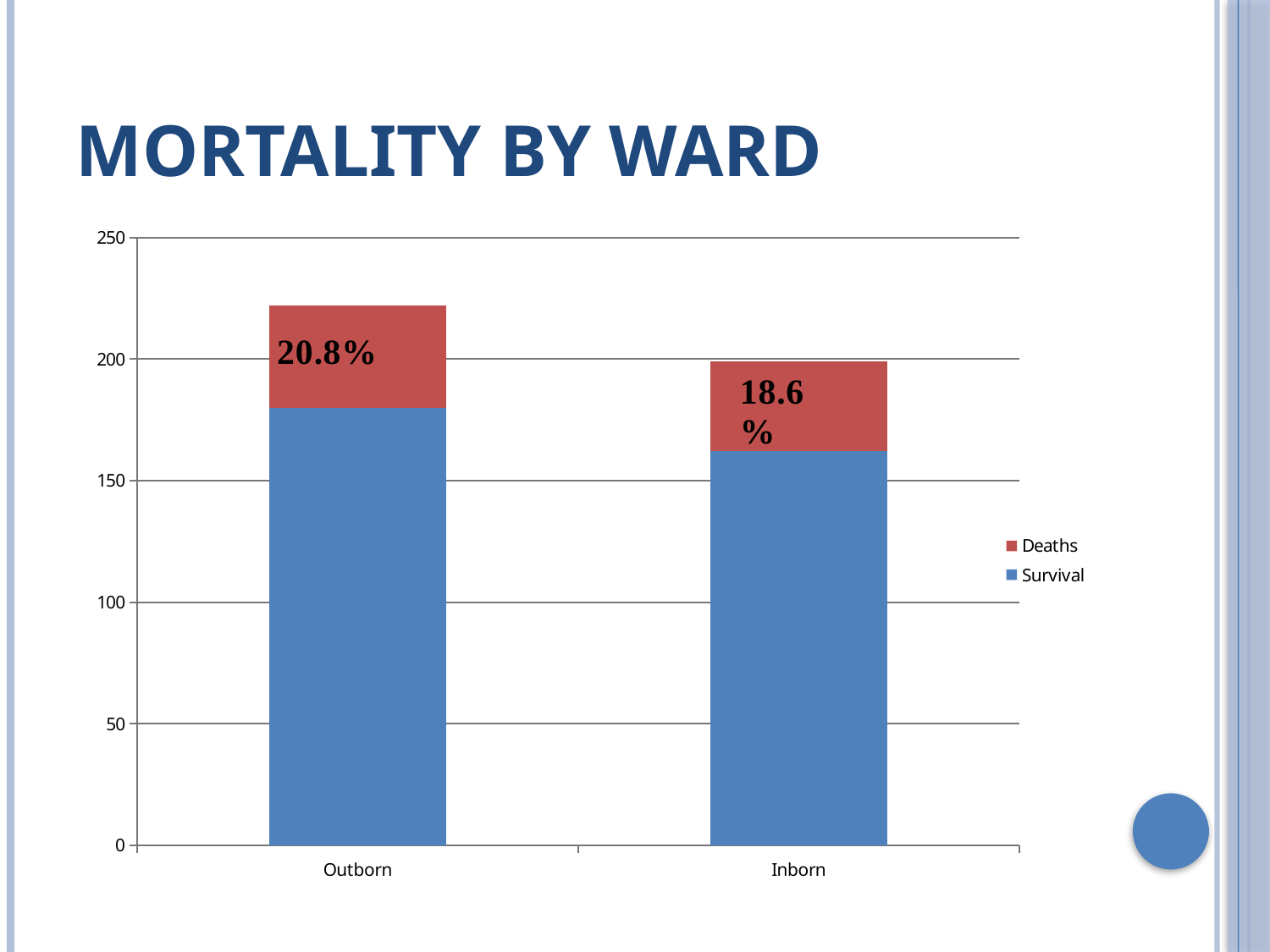
How many series does the chart legend list? 2 How many categories are shown on the x axis of the chart? 2 What mortality percentage is labelled on the Inborn bar? 18.6% What kind of chart is shown on the slide? Stacked bar chart Which category has the larger Survival value, Outborn or Inborn? Outborn Is the Survival value for Outborn greater or less than 150? greater Is the Survival value for Inborn greater or less than 200? less What mortality percentage is labelled on the Outborn bar? 20.8% What is the title of the slide containing the chart? MORTALITY BY WARD What are the two series named in the chart legend? Deaths and Survival Is the total height of the Outborn stacked bar greater or less than 200? greater Which category has the taller stacked bar, Outborn or Inborn? Outborn